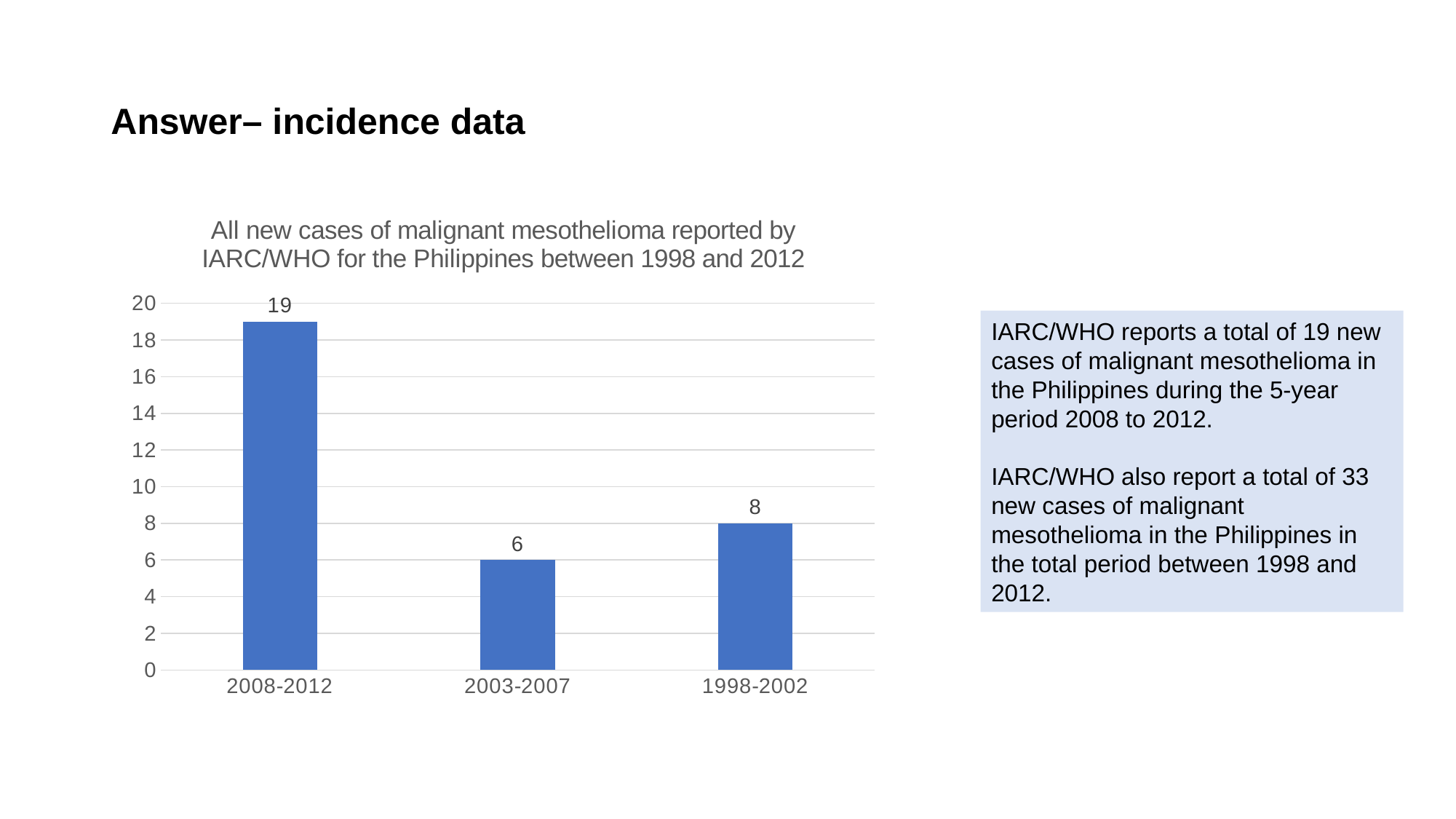
What is the value for 2003-2007? 6 What is the title of the chart? All new cases of malignant mesothelioma reported by IARC/WHO for the Philippines between 1998 and 2012 Which period has the lowest number of new cases? 2003-2007 Which is larger, the value for 2003-2007 or the value for 1998-2002? 1998-2002 How many periods are shown on the x axis? 3 Which period has the highest number of new cases? 2008-2012 What is the difference between the values for 2008-2012 and 1998-2002? 11 What is the difference between the values for 1998-2002 and 2003-2007? 2 What kind of chart is shown on the slide? bar chart Is the value for 2008-2012 greater or less than 10? greater What is the value for 2008-2012? 19 What is the value for 1998-2002? 8